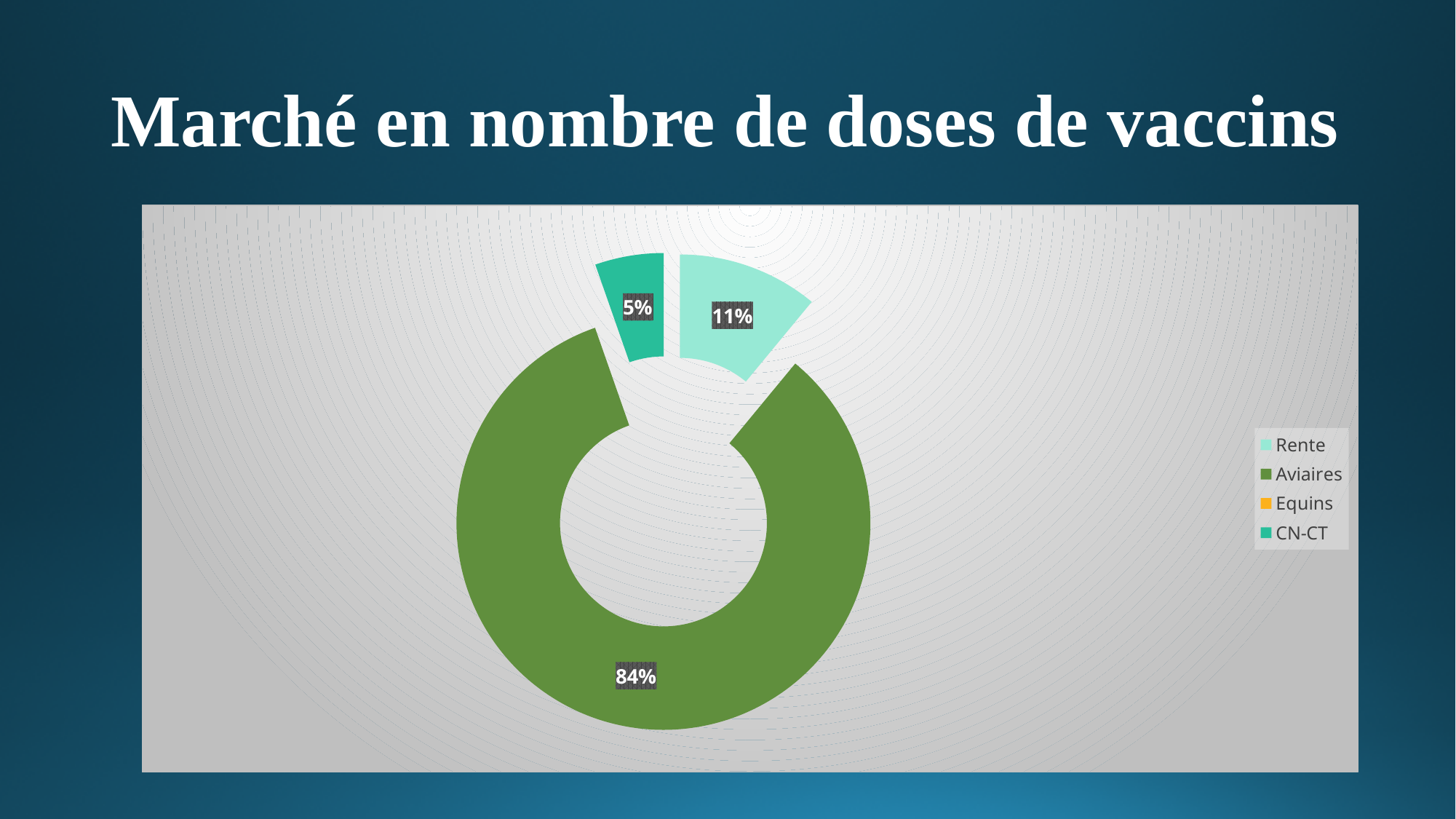
What is the difference in percentage points between the Aviaires share and the Rente share? 73 percentage points How many categories does the legend list? 4 What is the difference in percentage points between the Rente share and the CN-CT share? 6 percentage points Of Rente, Aviaires and CN-CT, which has the smallest share? CN-CT What percentage share does CN-CT have in the chart? 5% What percentage share does Aviaires have in the chart? 84% What colour represents Aviaires in the chart? Green Which has a larger share, Rente or CN-CT? Rente What kind of chart is shown on the slide? Doughnut (pie) chart Which category has the largest share of the chart? Aviaires What percentage share does Rente have in the chart? 11% What is the title of the slide? Marché en nombre de doses de vaccins